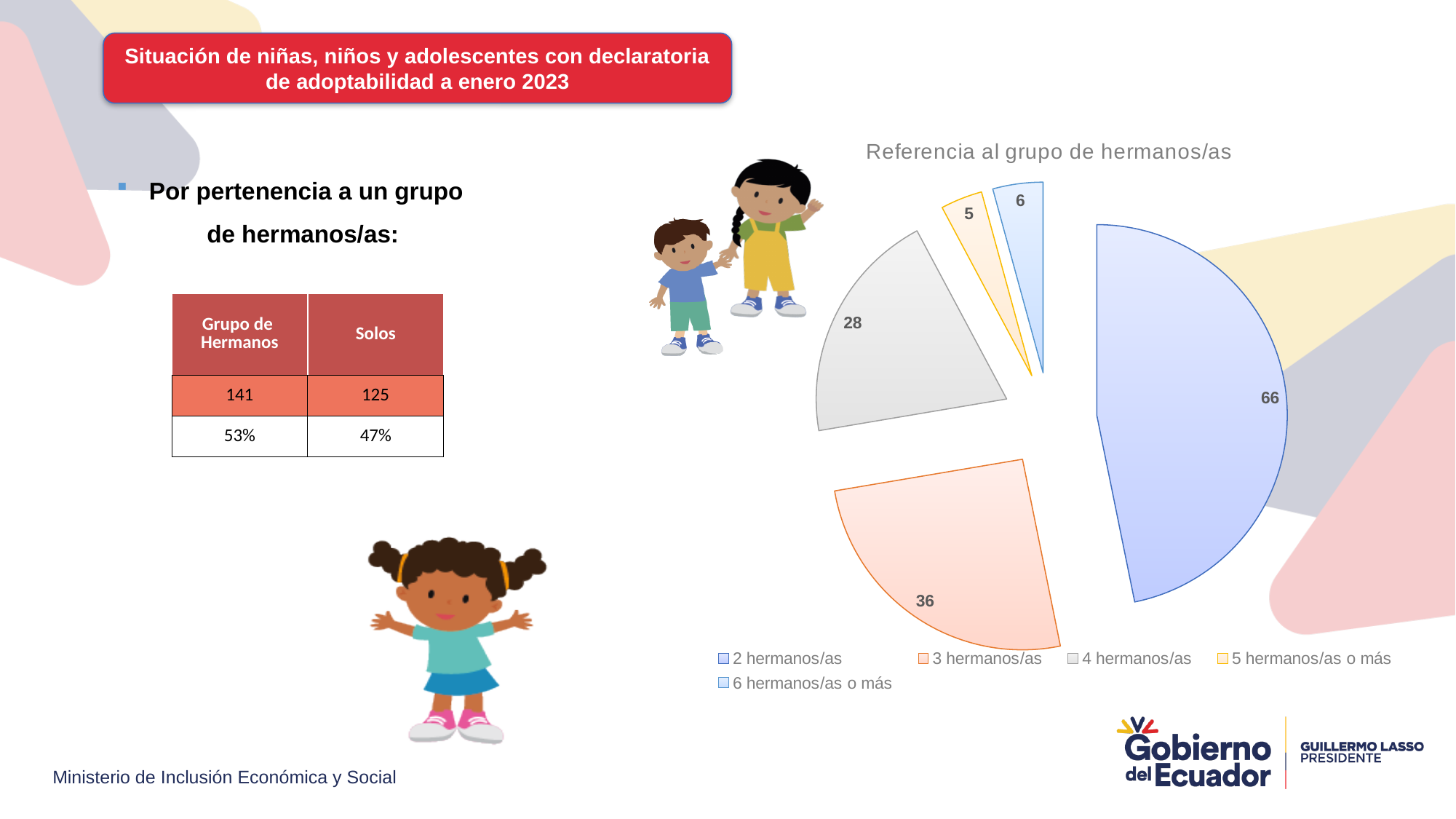
What is the difference between the '2 hermanos/as' and '3 hermanos/as' values in the pie chart? 30 Which category has the smallest slice in the pie chart? 5 hermanos/as o más What is the title of the pie chart? Referencia al grupo de hermanos/as What is the value for the '3 hermanos/as' slice in the pie chart? 36 What is the sum of all the slice values in the pie chart? 141 Which category has the largest slice in the pie chart? 2 hermanos/as How many slices does the pie chart have? 5 What is the value for the '2 hermanos/as' slice in the pie chart? 66 What is the value for the '4 hermanos/as' slice in the pie chart? 28 What is the value for the '5 hermanos/as o más' slice in the pie chart? 5 What type of chart is shown on the slide? Pie chart What is the value for the '6 hermanos/as o más' slice in the pie chart? 6